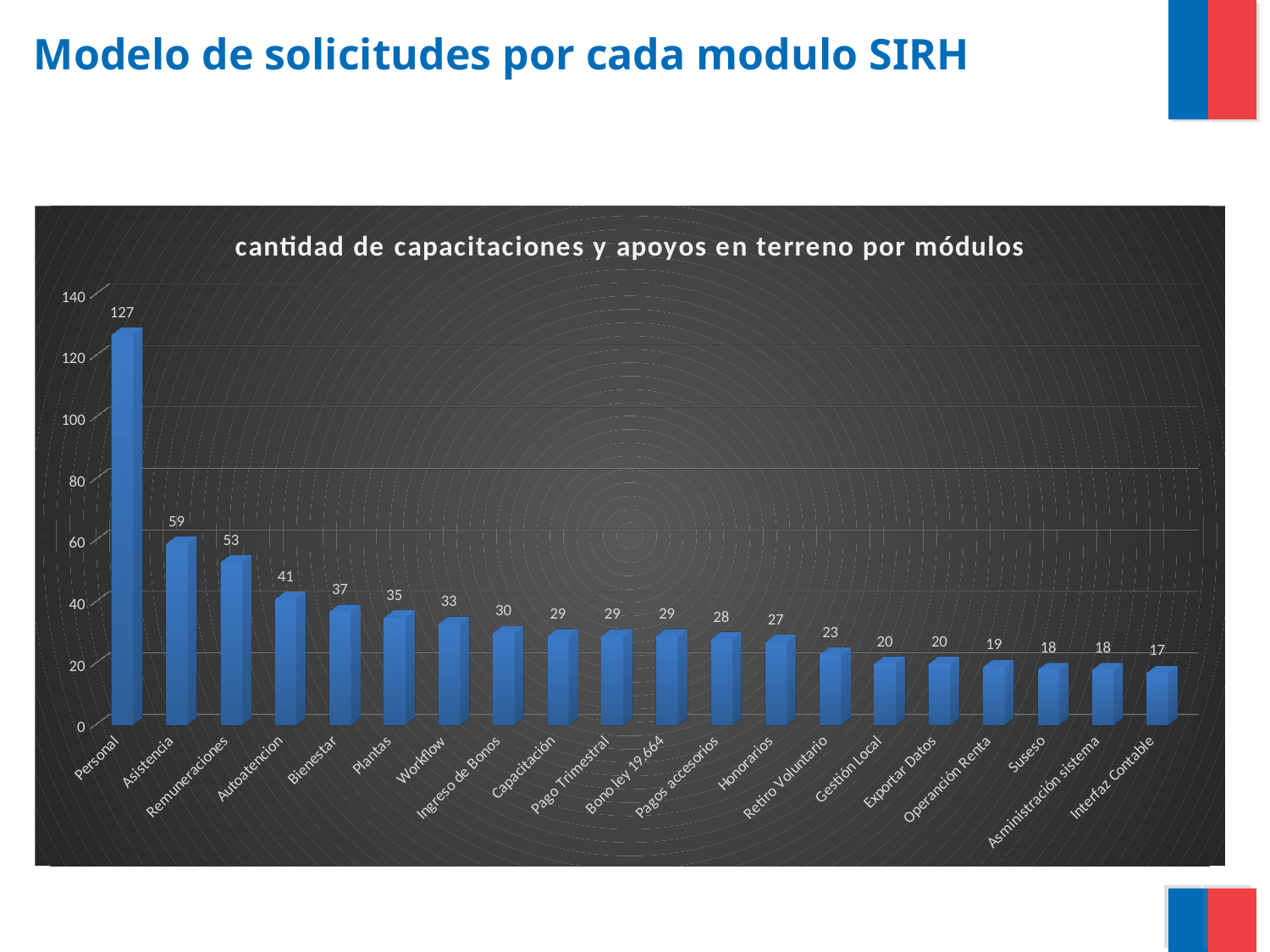
Which is larger, the value for Workflow or the value for Retiro Voluntario? Workflow Is the value for Asistencia greater or less than 40? greater What is the value for Personal? 127 What is the value for Remuneraciones? 53 What is the value for Honorarios? 27 What is the difference between the values for Autoatencion and Bienestar? 4 Which category has the lowest value? Interfaz Contable Which category has the highest value? Personal How many categories are shown on the x axis? 20 What is the difference between the values for Personal and Asistencia? 68 What kind of chart is shown on the slide? Bar chart What is the title of the chart? cantidad de capacitaciones y apoyos en terreno por módulos